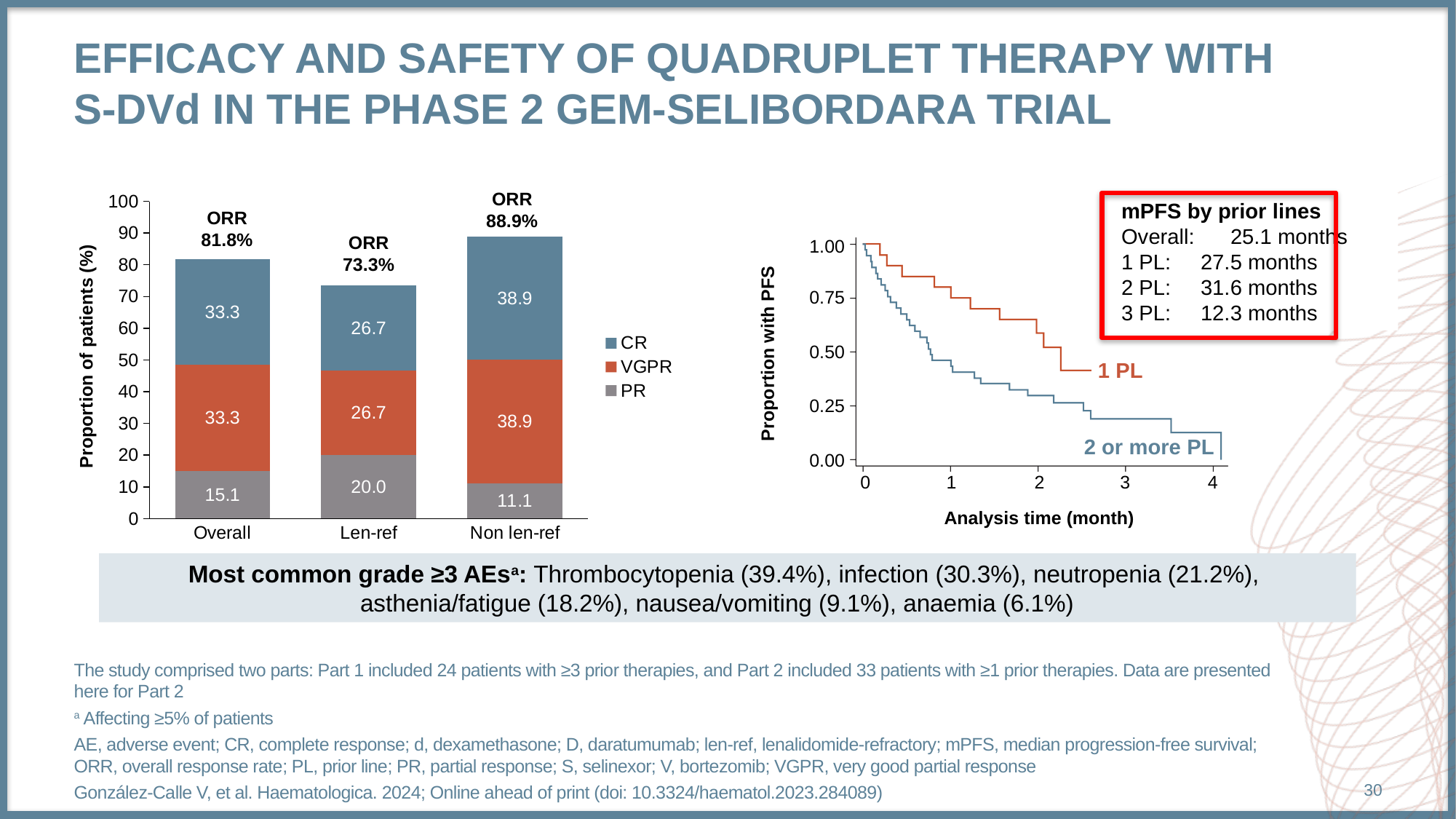
In the PFS chart on the right, is the proportion with PFS for the 2 or more PL curve at 1 month greater or less than 0.50? less In the bar chart on the left, how many series does the legend list? 3 In the bar chart on the left, what ORR is shown above the Overall bar? 81.8% In the bar chart on the left, which group has the highest ORR? Non len-ref In the PFS chart on the right, what is the label of the x axis? Analysis time (month) In the bar chart on the left, what is the difference between the CR values for Non len-ref and Len-ref? 12.2 In the bar chart on the left, what is the CR value for the Non len-ref group? 38.9 In the bar chart on the left, how many groups are shown on the x axis? 3 In the bar chart on the left, is the VGPR value larger for Overall or for Len-ref? Overall In the bar chart on the left, what is the PR value for the Len-ref group? 20.0 What kind of chart is the chart on the left? Stacked bar chart In the bar chart on the left, which group has the lowest PR value? Non len-ref